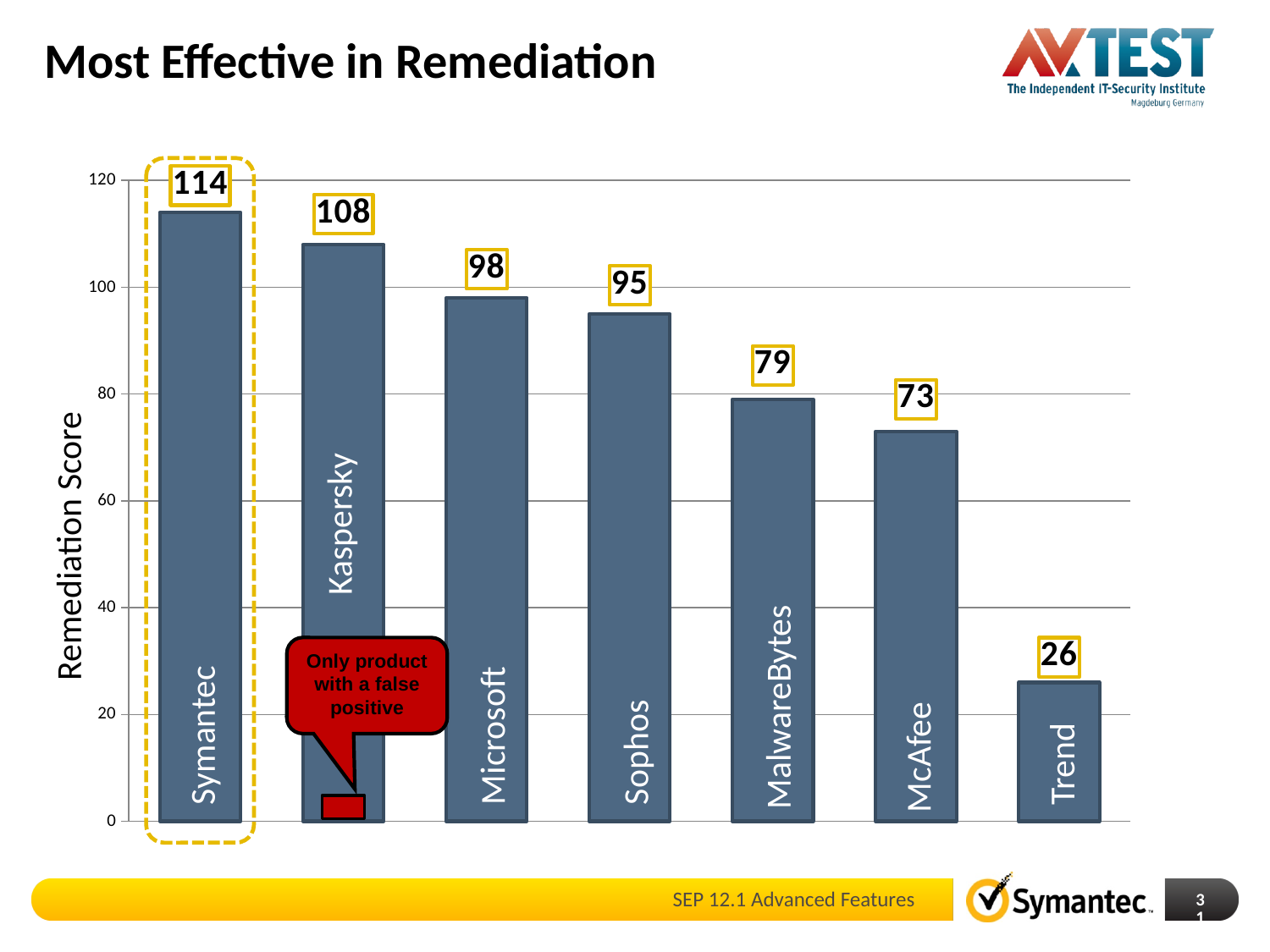
What is the difference between the remediation scores of Symantec and Kaspersky? 6 What is the difference between the remediation scores of Sophos and Trend? 69 What kind of chart is shown on the slide? Bar chart What is the remediation score for McAfee? 73 How many products are shown in the chart? 7 Which product has the lowest remediation score? Trend Do the remediation scores rise or fall from left to right across the chart? Fall What is the remediation score for Microsoft? 98 Which product has the highest remediation score? Symantec What is the remediation score for Kaspersky? 108 Which has a higher remediation score, MalwareBytes or McAfee? MalwareBytes What is the remediation score for Symantec? 114